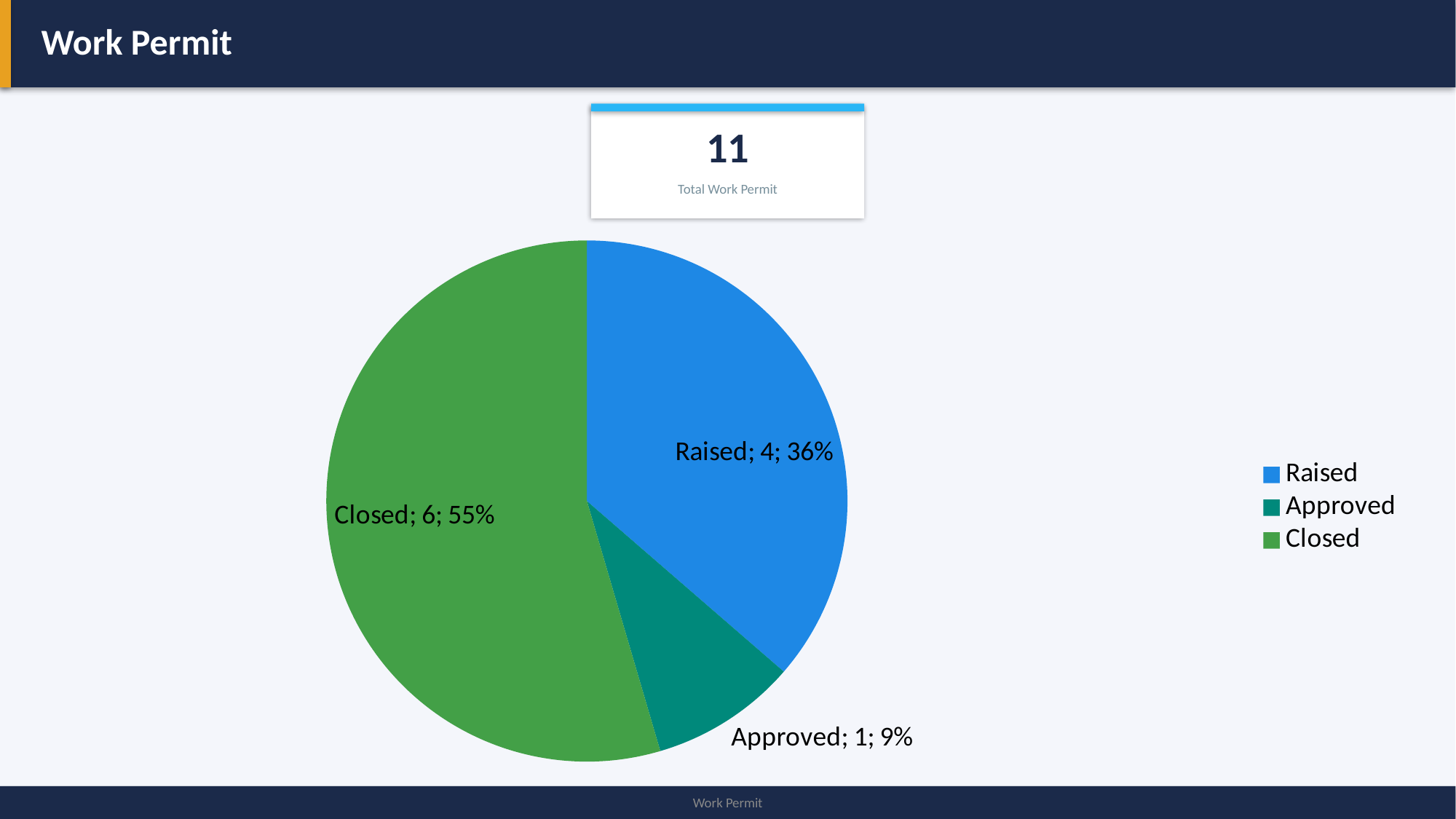
How many categories does the pie chart have? 3 What kind of chart is shown on the slide? pie chart What is the difference between the number of Closed and Raised work permits? 2 What share of the pie does the Raised slice represent? 36% What colour is the Closed slice in the pie chart? green Which category has the smallest slice of the pie? Approved How many work permits are Closed? 6 What share of the pie does the Closed slice represent? 55% How many work permits are Approved? 1 How many work permits are Raised? 4 Which is larger, the Raised slice or the Approved slice? Raised Which category has the largest slice of the pie? Closed